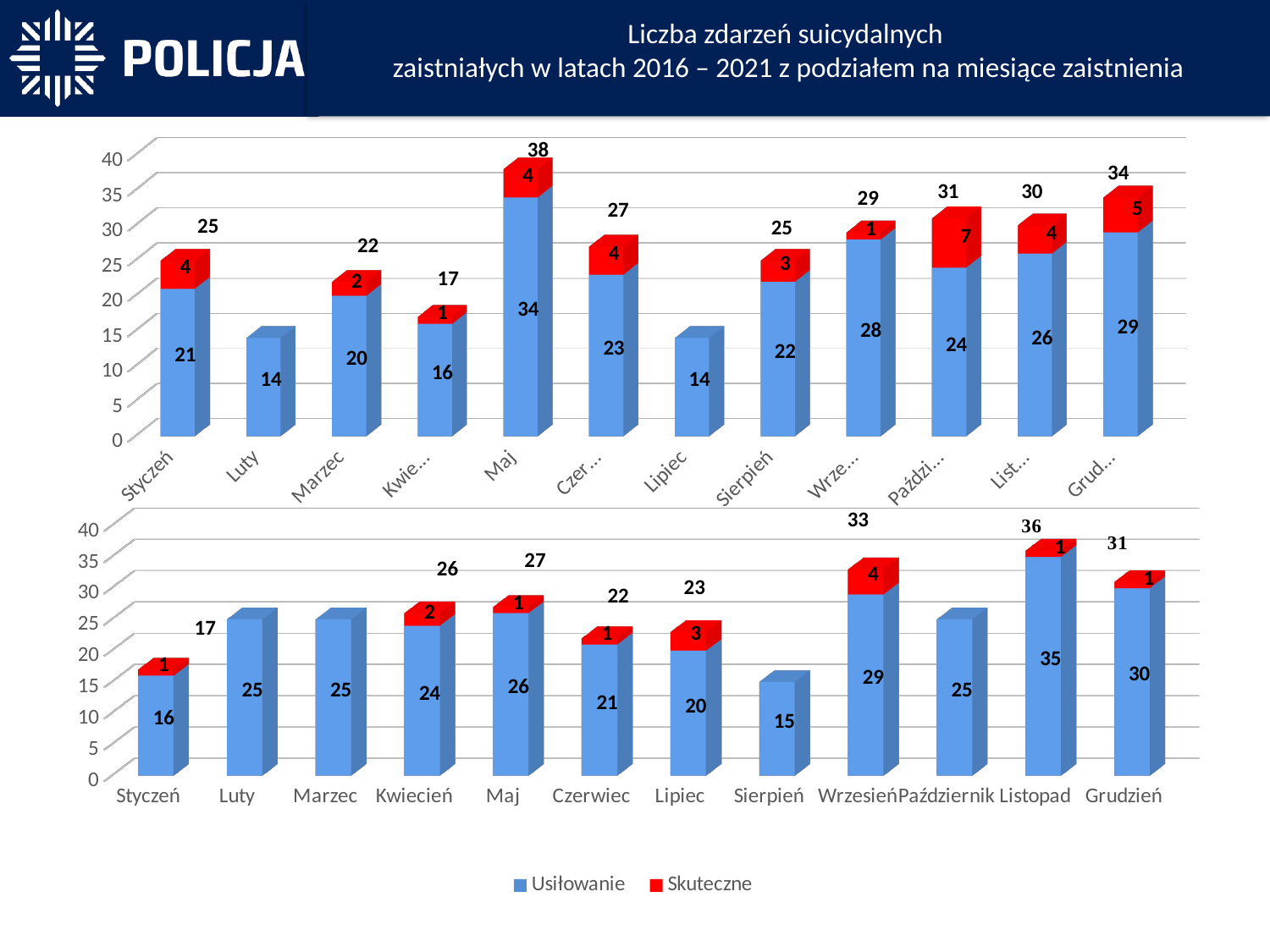
In the bottom chart, what is the difference between the totals for Listopad and Styczeń? 19 In the bottom chart, which month has the lowest total? Sierpień In the top chart, which month has the highest total? Maj What kind of chart is the top chart? Stacked bar chart How many months are shown on the x axis of the bottom chart? 12 In the bottom chart, which is larger, the total for Wrzesień or the total for Grudzień? Wrzesień In the bottom chart, what is the Usiłowanie value for Listopad? 35 How many series does the legend list? 2 In the bottom chart, what is the Skuteczne value for Wrzesień? 4 In the top chart, what is the Usiłowanie value for Maj? 34 In the top chart, what is the total of the stacked bar for Sierpień? 25 In the top chart, what is the Skuteczne value for Styczeń? 4